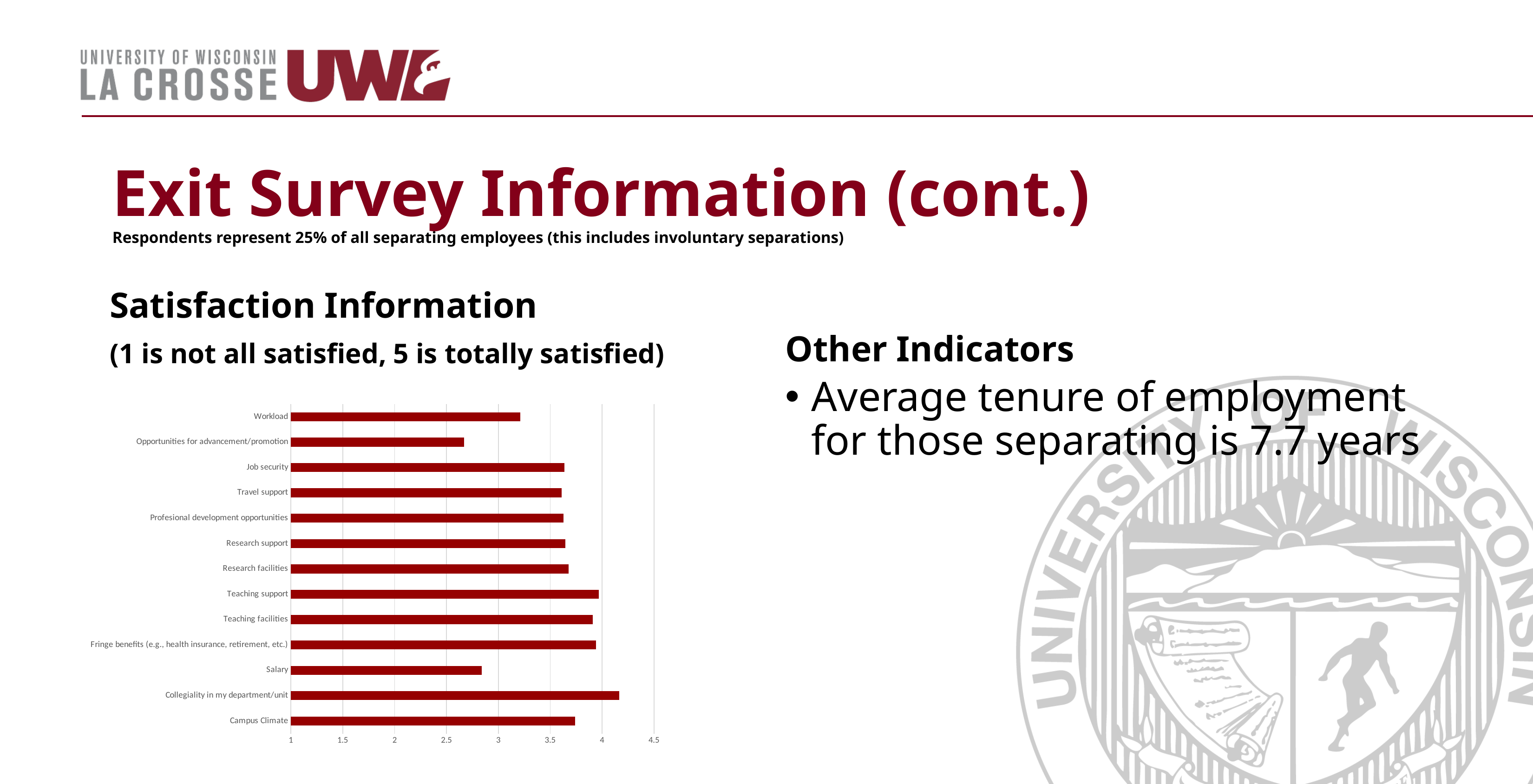
Which has a higher satisfaction score, Workload or Salary? Workload Is the satisfaction value for Workload greater or less than 3? greater Which category has the highest satisfaction score in the bar chart? Collegiality in my department/unit What colour are the bars in the satisfaction chart? Dark red (maroon) How many categories are plotted in the satisfaction bar chart? 13 Which category has the lowest satisfaction score in the bar chart? Opportunities for advancement/promotion What kind of chart is shown under Satisfaction Information? Bar chart Is the satisfaction value for Salary greater or less than 3? less Which has a higher satisfaction score, Salary or Opportunities for advancement/promotion? Salary Is the satisfaction value for Campus Climate greater or less than 3.5? greater Which has a higher satisfaction score, Teaching support or Research facilities? Teaching support